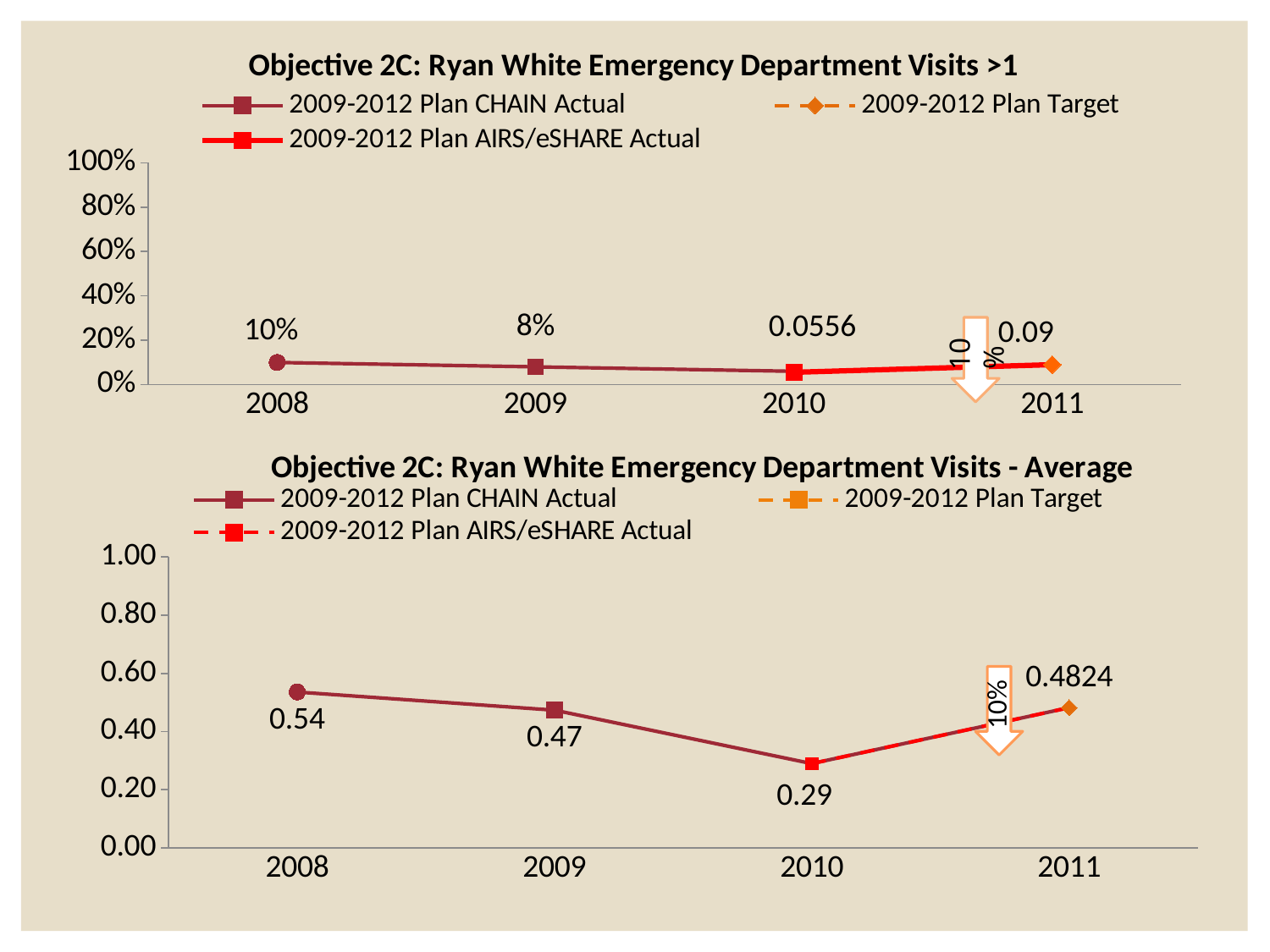
In the top chart (Emergency Department Visits >1), what is the value labelled for 2010? 0.0556 What kind of chart is the top chart (Emergency Department Visits >1)? Line chart How many series does the legend of the bottom chart (Emergency Department Visits - Average) list? 3 In the top chart (Emergency Department Visits >1), what is the value labelled for 2008? 10% In the bottom chart (Emergency Department Visits - Average), which year has the lowest value? 2010 In the bottom chart (Emergency Department Visits - Average), what is the difference between the 2009 value and the 2010 value? 0.18 In the bottom chart (Emergency Department Visits - Average), is the value for 2010 greater or less than 0.40? less In the top chart (Emergency Department Visits >1), what is the value labelled for 2011? 0.09 In the top chart (Emergency Department Visits >1), what is the difference between the 2008 value and the 2009 value? 2% In the bottom chart (Emergency Department Visits - Average), what is the value labelled for 2009? 0.47 In the bottom chart (Emergency Department Visits - Average), which year has the highest value? 2008 In the bottom chart (Emergency Department Visits - Average), what is the value labelled for 2011? 0.4824